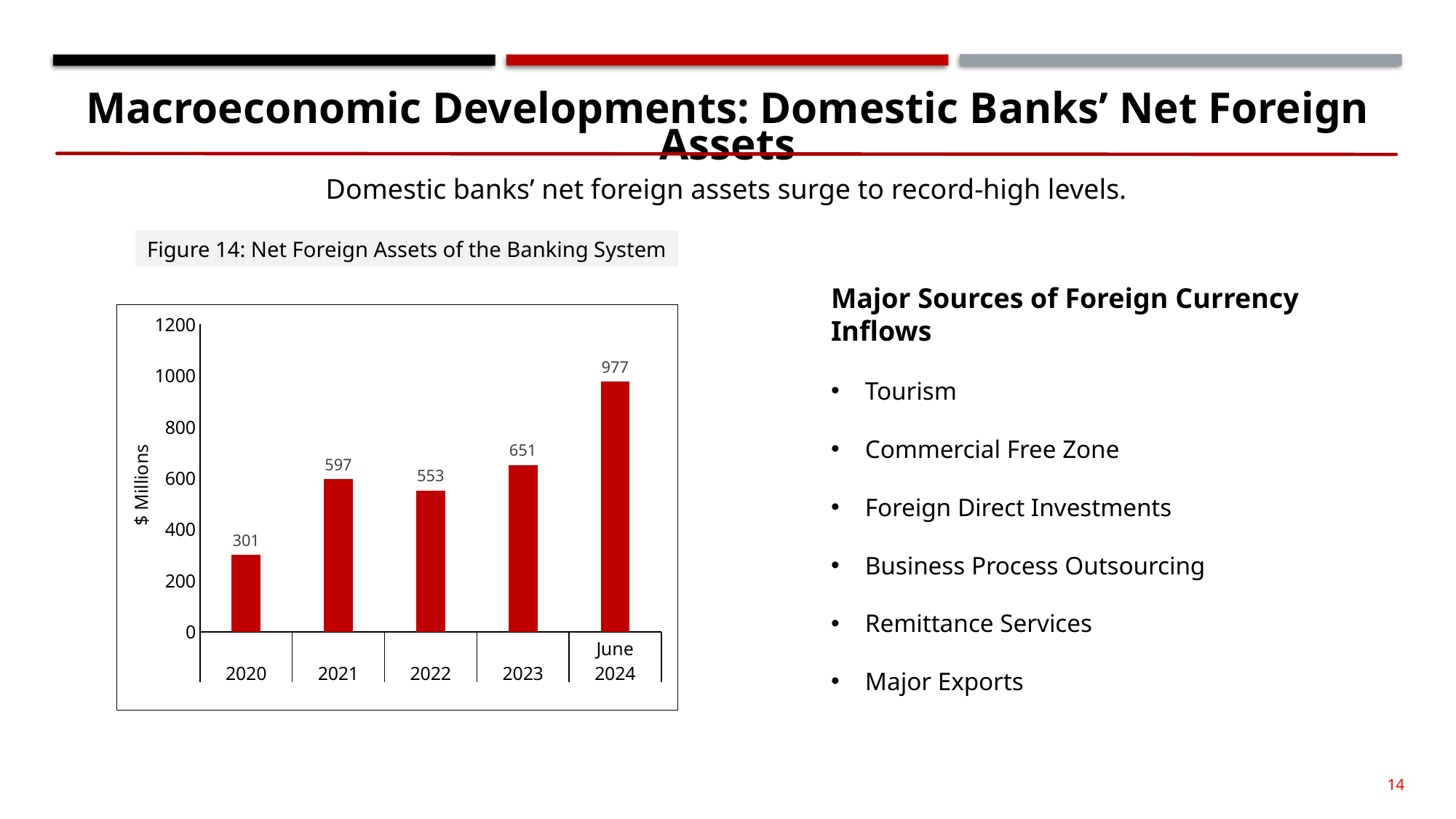
Which is larger in the chart, the value for 2021 or the value for 2022? 2021 What kind of chart is Figure 14? Bar chart Which period has the highest net foreign assets in the chart? June 2024 What is the difference between the values for 2021 and 2022 in the chart? 44 Which period has the lowest net foreign assets in the chart? 2020 What is the value for June 2024 in the Net Foreign Assets of the Banking System chart? 977 What is the y-axis label of the Net Foreign Assets of the Banking System chart? $ Millions What is the value for 2020 in the Net Foreign Assets of the Banking System chart? 301 What is the difference between the values for June 2024 and 2023 in the chart? 326 How many bars are plotted in the Net Foreign Assets of the Banking System chart? 5 Is the value for 2023 in the chart greater or less than 600? greater What is the value for 2022 in the Net Foreign Assets of the Banking System chart? 553